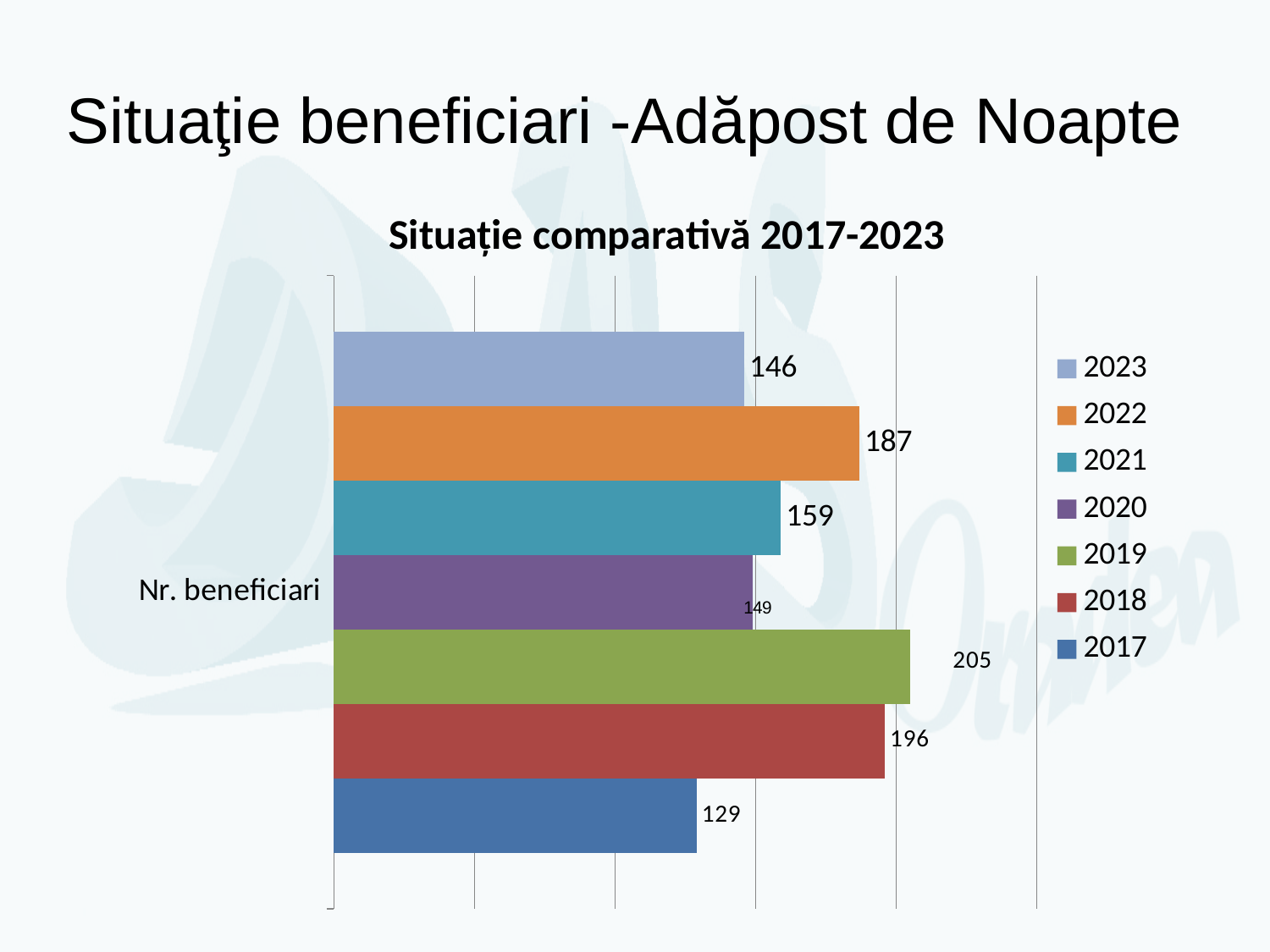
Which year has the lowest number of beneficiaries? 2017 What is the value for 2021 in the chart? 159 What is the value for 2022 in the chart? 187 What is the value for 2023 in the chart? 146 What is the value for 2020 in the chart? 149 Which is larger, the value for 2021 or the value for 2020? 2021 Which year has the highest number of beneficiaries? 2019 What is the value for 2017 in the chart? 129 What is the difference between the values for 2022 and 2023? 41 What is the difference between the values for 2019 and 2018? 9 What kind of chart is shown on the slide? Bar chart How many series does the legend list? 7